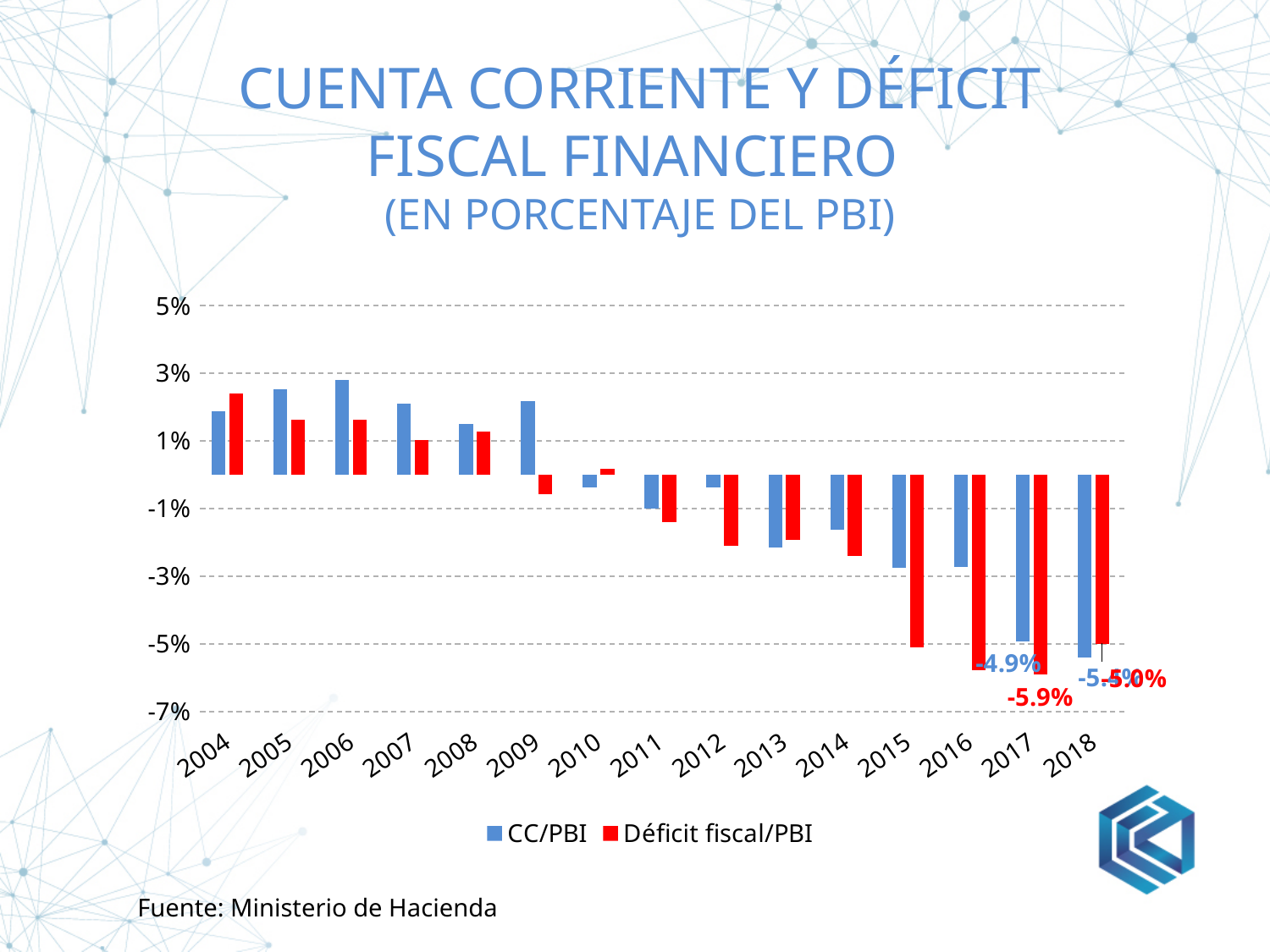
In which year is the Déficit fiscal/PBI value the lowest? 2017 In 2017, which series has the lower value, CC/PBI or Déficit fiscal/PBI? Déficit fiscal/PBI How many years are shown on the x axis? 15 Is the Déficit fiscal/PBI value for 2015 greater or less than -3%? less What is the difference between the CC/PBI and Déficit fiscal/PBI values in 2017? 1.0% What kind of chart is shown on the slide? bar chart In which year is the Déficit fiscal/PBI value the highest? 2004 Is the CC/PBI value for 2006 greater or less than 1%? greater How many series does the legend list? 2 What is the Déficit fiscal/PBI value for 2017? -5.9% Does the CC/PBI series generally rise or fall from 2009 to 2018? fall What is the CC/PBI value for 2017? -4.9%